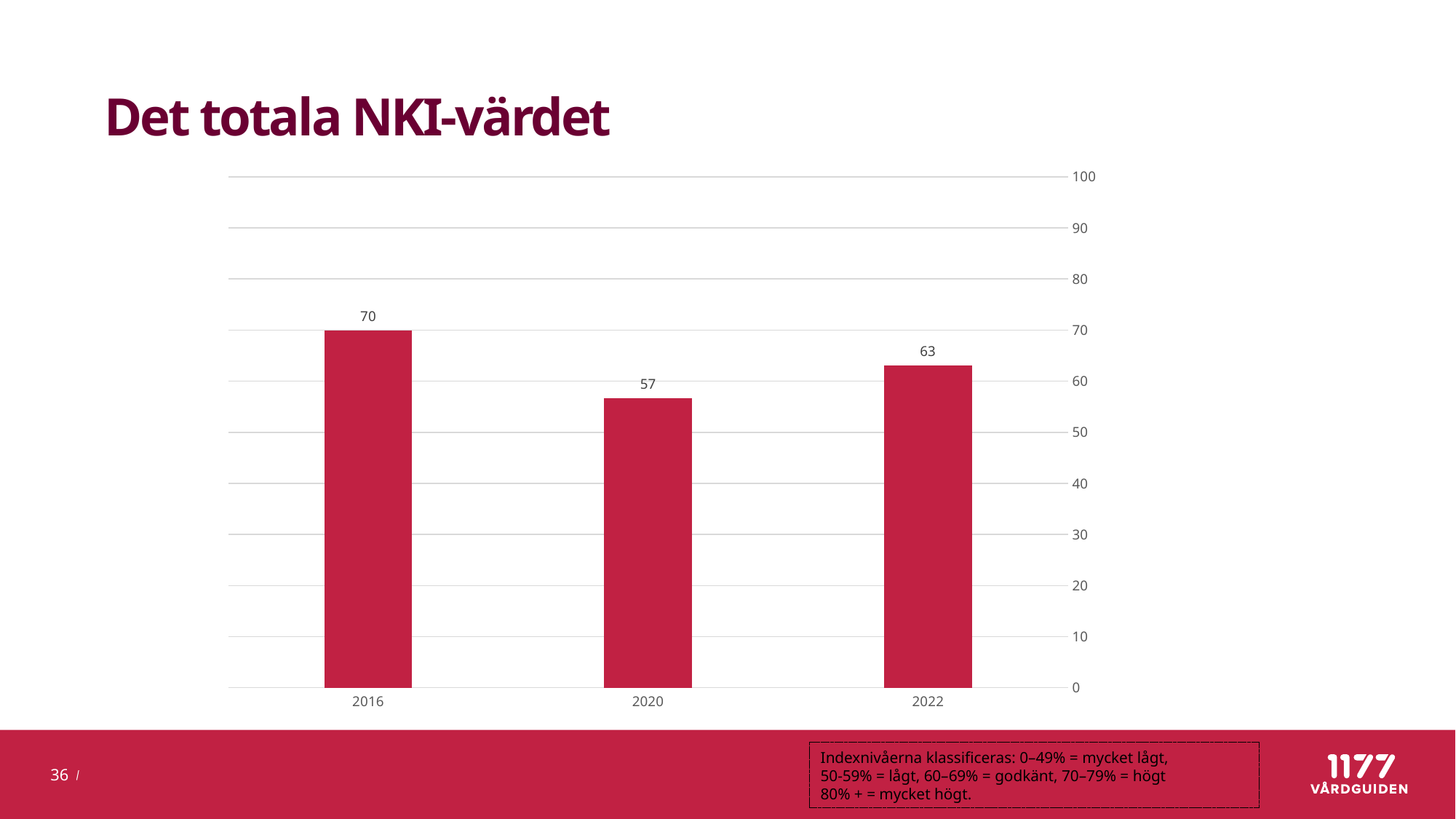
Which is larger, the value for 2022 or the value for 2020? 2022 What is the NKI value for 2020? 57 How many years are shown on the chart? 3 Which year has the lowest NKI value? 2020 What kind of chart is shown on the slide? bar chart What is the title of the slide? Det totala NKI-värdet Is the value for 2020 greater or less than 60? less What is the difference between the NKI values for 2016 and 2020? 13 What is the NKI value for 2022? 63 Which year has the highest NKI value? 2016 What is the NKI value for 2016? 70 What is the difference between the NKI values for 2022 and 2020? 6